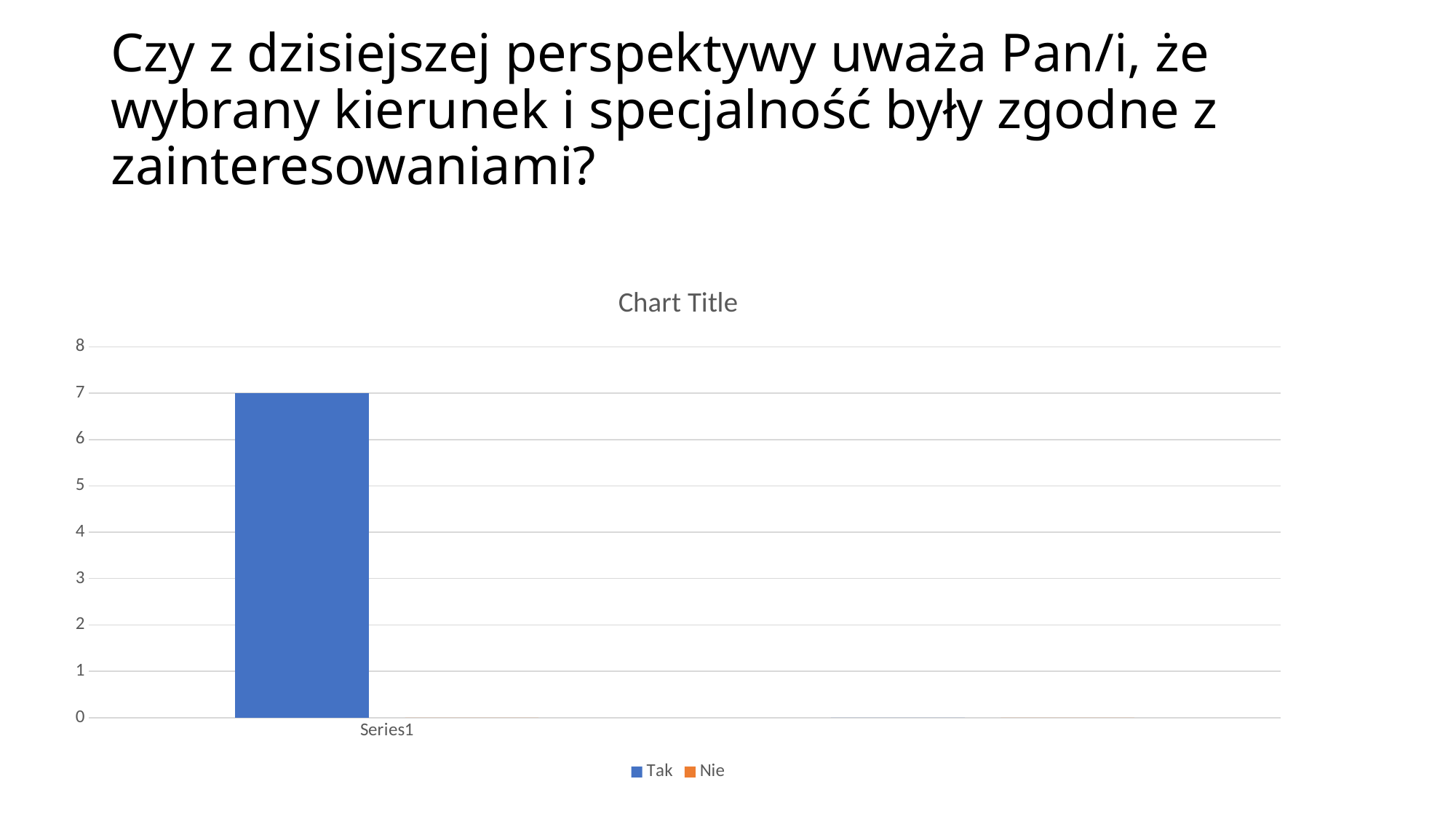
What is the value of the Tak bar? 7 How many series does the legend list? 2 How many categories are shown on the x axis? 1 Is the value for Tak greater or less than 8? less What is the label of the category on the x axis? Series1 Which series has the higher value, Tak or Nie? Tak What is the maximum value shown on the y axis? 8 Is the value for Tak greater or less than 5? greater What kind of chart is shown on the slide? bar chart Which series has the highest value in the chart? Tak What are the two series named in the legend? Tak and Nie